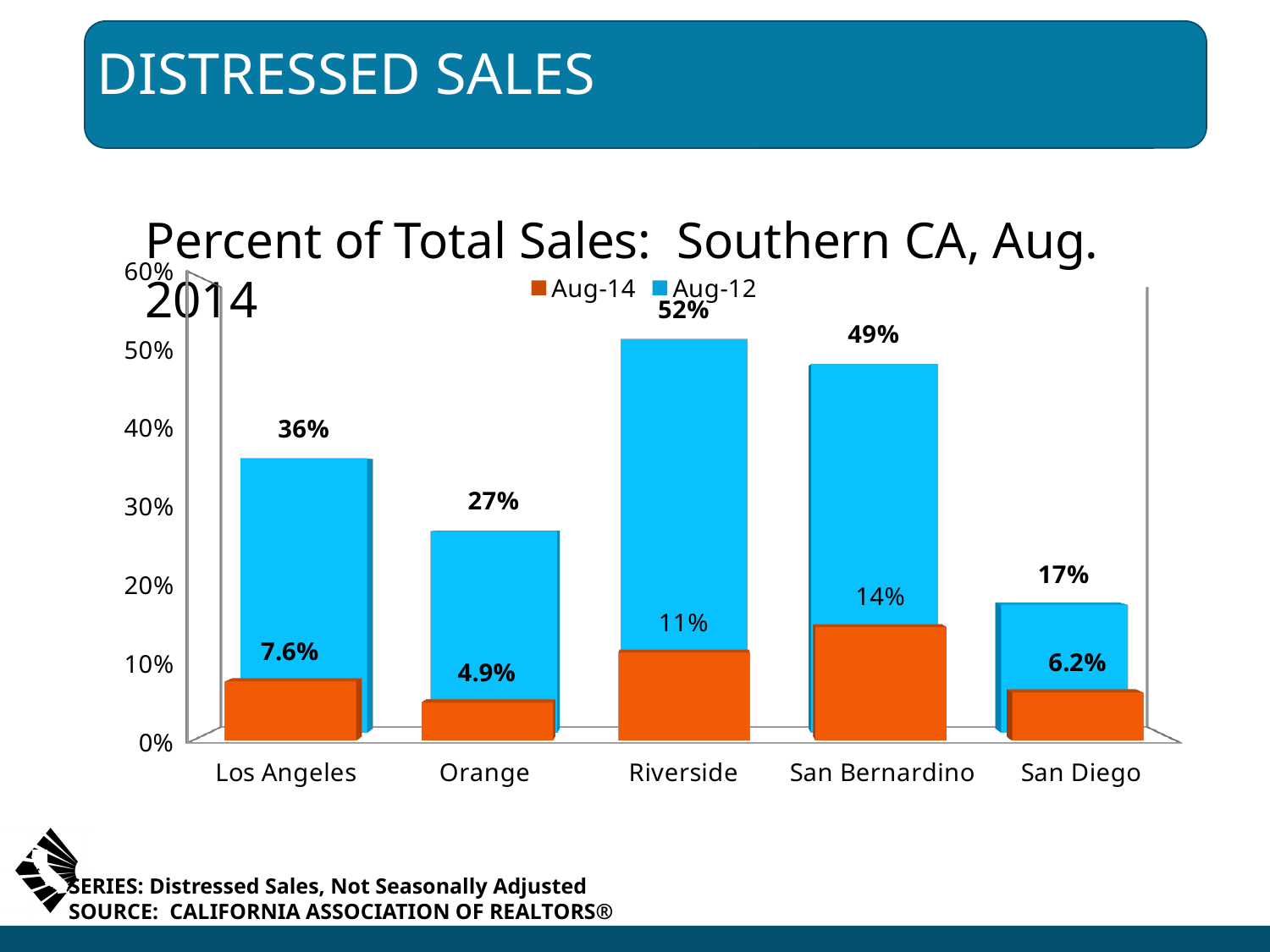
Which county has the highest Aug-12 value? Riverside Is the Aug-12 value for Los Angeles greater or less than 30%? greater What is the Aug-14 value for San Bernardino? 14% What is the Aug-12 value for San Diego? 17% What is the Aug-12 value for Riverside? 52% What is the difference between the Aug-12 and Aug-14 values for Orange? 22.1% How many series does the legend list? 2 Which is larger, the Aug-14 value for Riverside or the Aug-14 value for San Bernardino? San Bernardino What kind of chart is shown on the slide? bar chart What is the Aug-14 value for Los Angeles? 7.6% Which county has the lowest Aug-14 value? Orange How many counties are shown on the x axis? 5